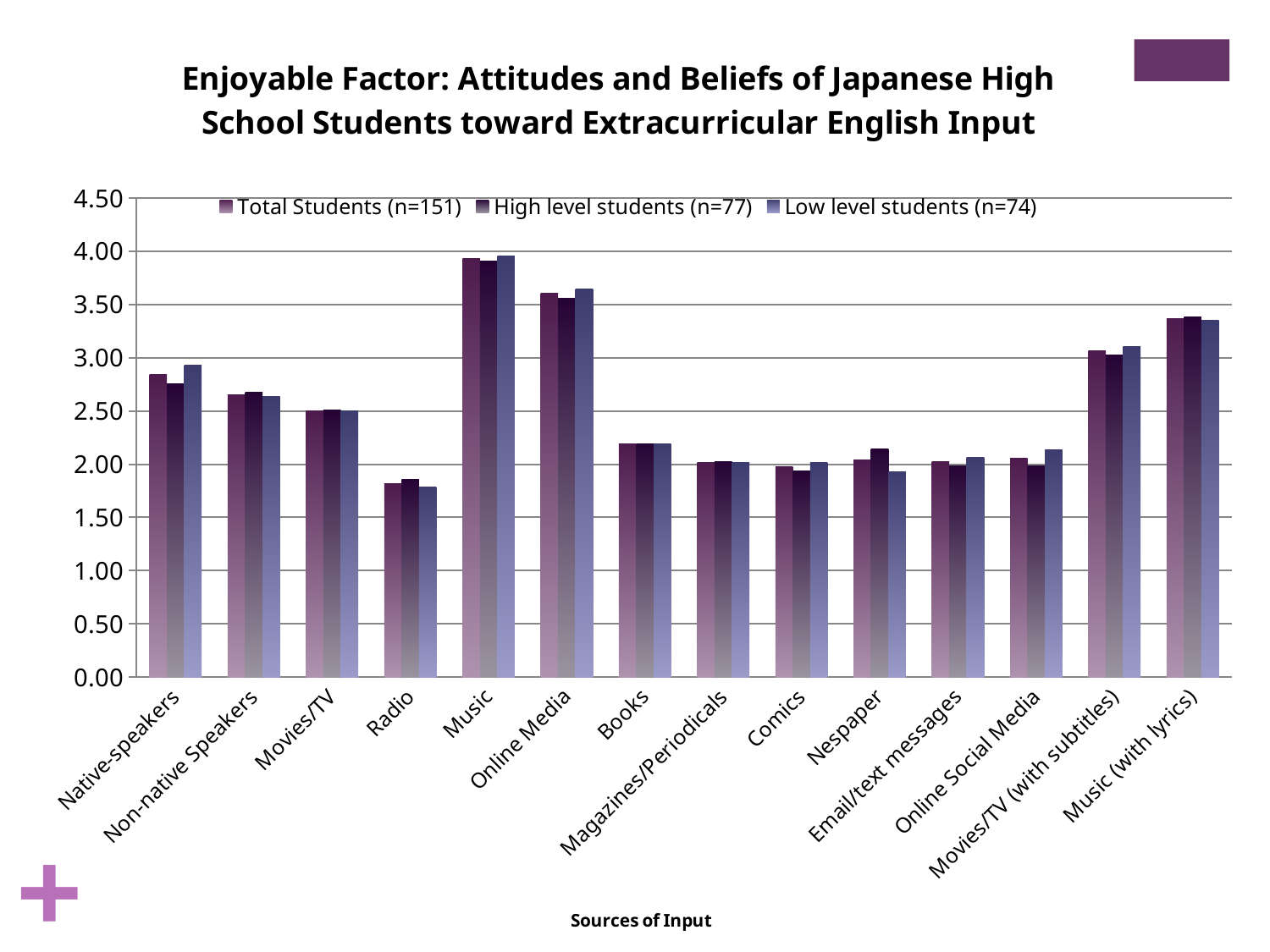
Which source of input has the lowest values across all three series? Radio What is the title of the x axis? Sources of Input Which source of input has the highest values across all three series? Music How many source-of-input categories are shown on the x axis? 14 How many series does the legend list? 3 Is the Total Students value for Music (with lyrics) greater or less than 3.00? greater For Total Students, which is larger: Movies/TV (with subtitles) or Books? Movies/TV (with subtitles) What kind of chart is shown on the slide? bar chart Is the Total Students value for Radio greater or less than 2.00? less Is the Low level students value for Native-speakers greater or less than 2.50? greater For Total Students, which is larger: Music or Online Media? Music